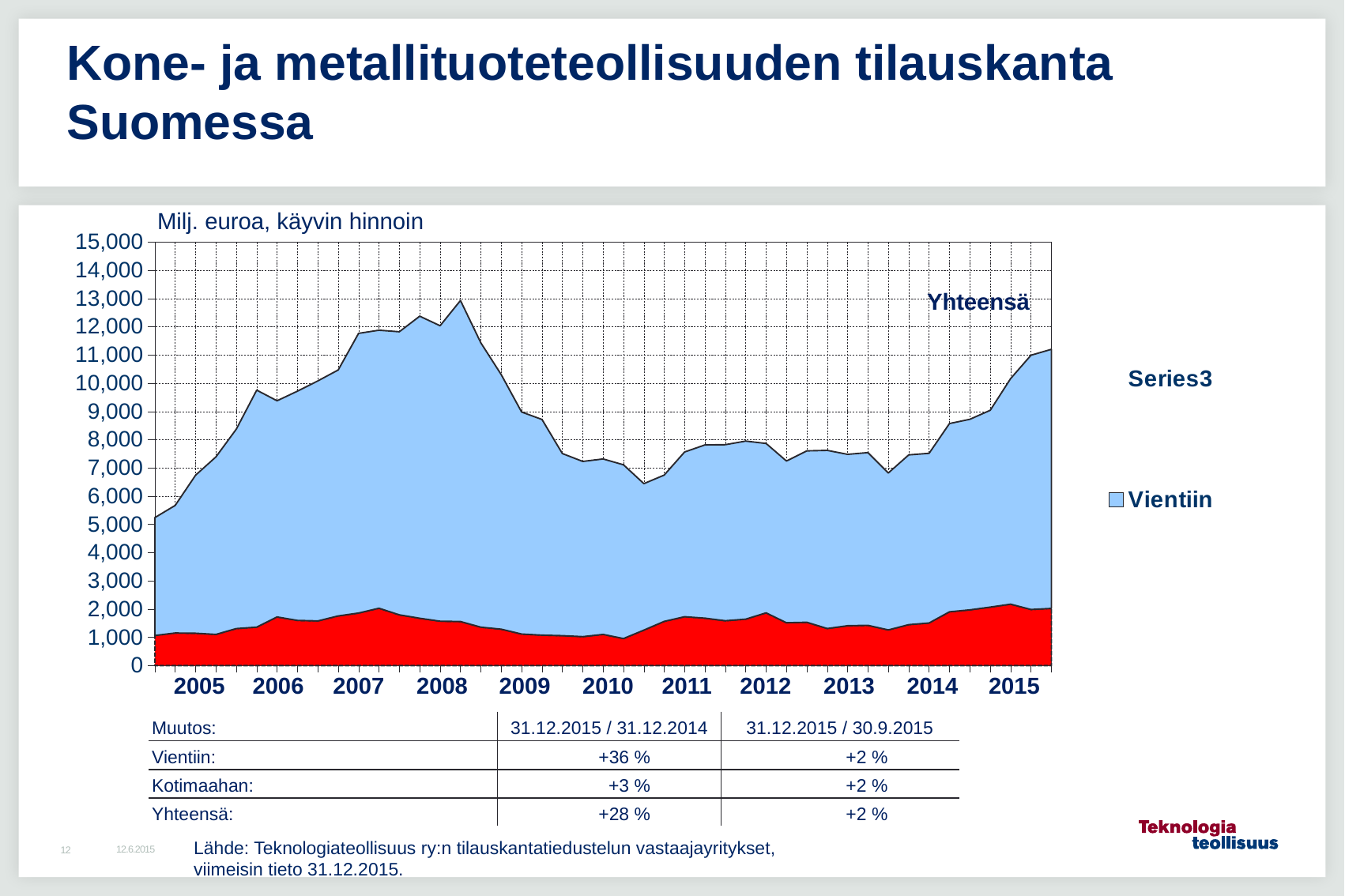
How many series does the chart legend list? 2 Is the total (Yhteensä) at the start of 2005 greater or less than 6,000? less How many years are labelled on the x axis of the chart? 11 Which is higher, the total (Yhteensä) in 2008 or in 2010? 2008 Does the total (Yhteensä) rise or fall from its 2008 peak to 2009? Fall What kind of chart is shown on the slide? Area chart In which year does the total (Yhteensä) order book reach its highest level? 2008 What is the unit label shown above the chart? Milj. euroa, käyvin hinnoin In which year is the total (Yhteensä) order book at its lowest level? 2005 Is the peak value of the total (Yhteensä) in 2008 greater or less than 12,000? greater What are the two entries in the chart legend? Series3 and Vientiin Is the total (Yhteensä) at the end of 2015 greater or less than 10,000? greater